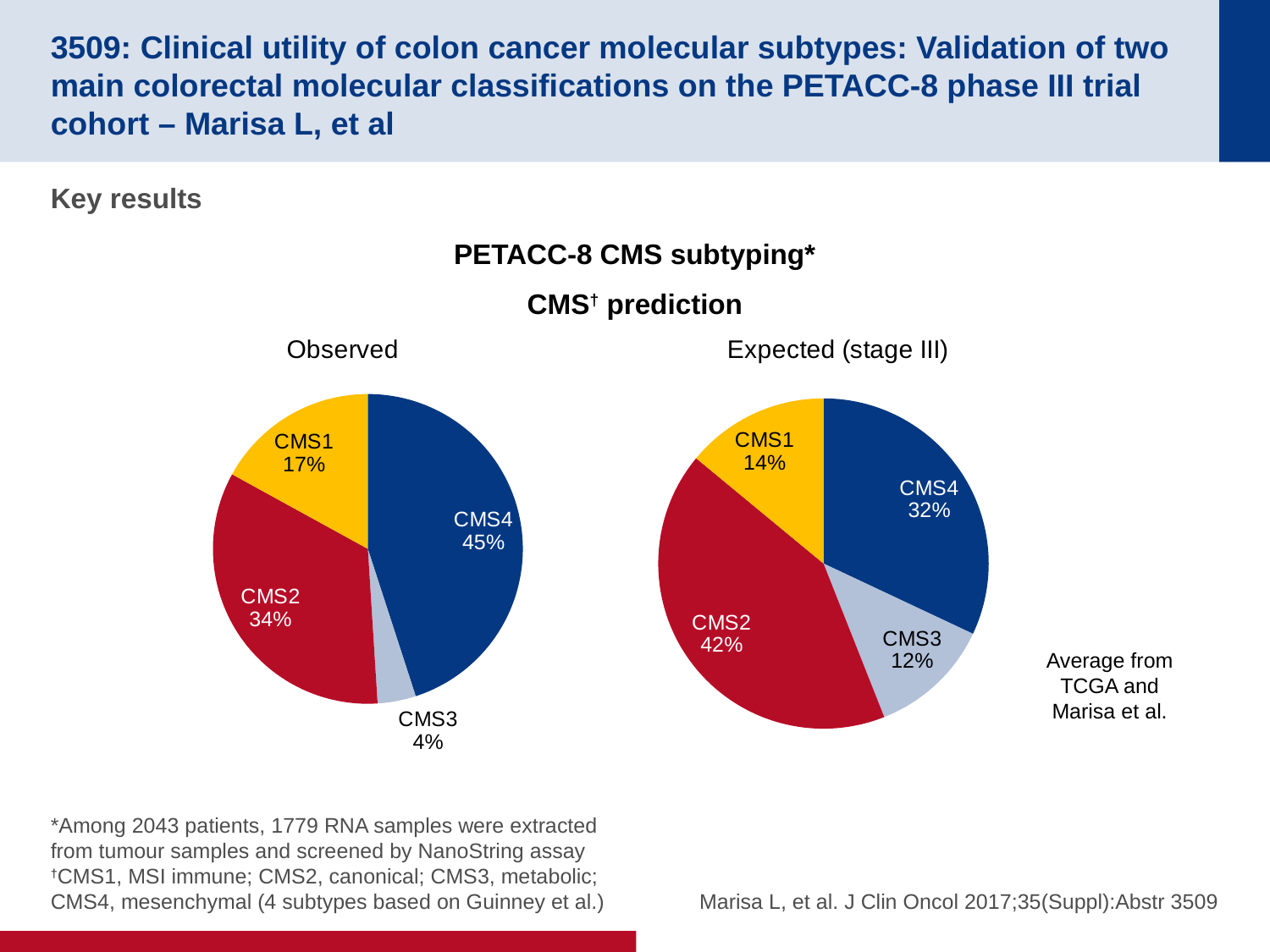
In the Observed pie chart, what is the share for CMS4? 45% Is the CMS2 share larger in the Observed pie chart or in the Expected (stage III) pie chart? Expected (stage III) What colour is the CMS2 slice in both pie charts? Red What is the difference between the CMS4 share in the Observed pie chart and the CMS4 share in the Expected (stage III) pie chart? 13 percentage points In the Observed pie chart, which subtype has the largest share? CMS4 In the Expected (stage III) pie chart, which subtype has the smallest share? CMS3 In the Expected (stage III) pie chart, which subtype has the largest share? CMS2 What type of chart is used to show the CMS prediction data? Pie chart How many slices does the Observed pie chart have? 4 In the Expected (stage III) pie chart, what is the share for CMS1? 14% In the Observed pie chart, what is the share for CMS3? 4% In the Expected (stage III) pie chart, what is the share for CMS2? 42%